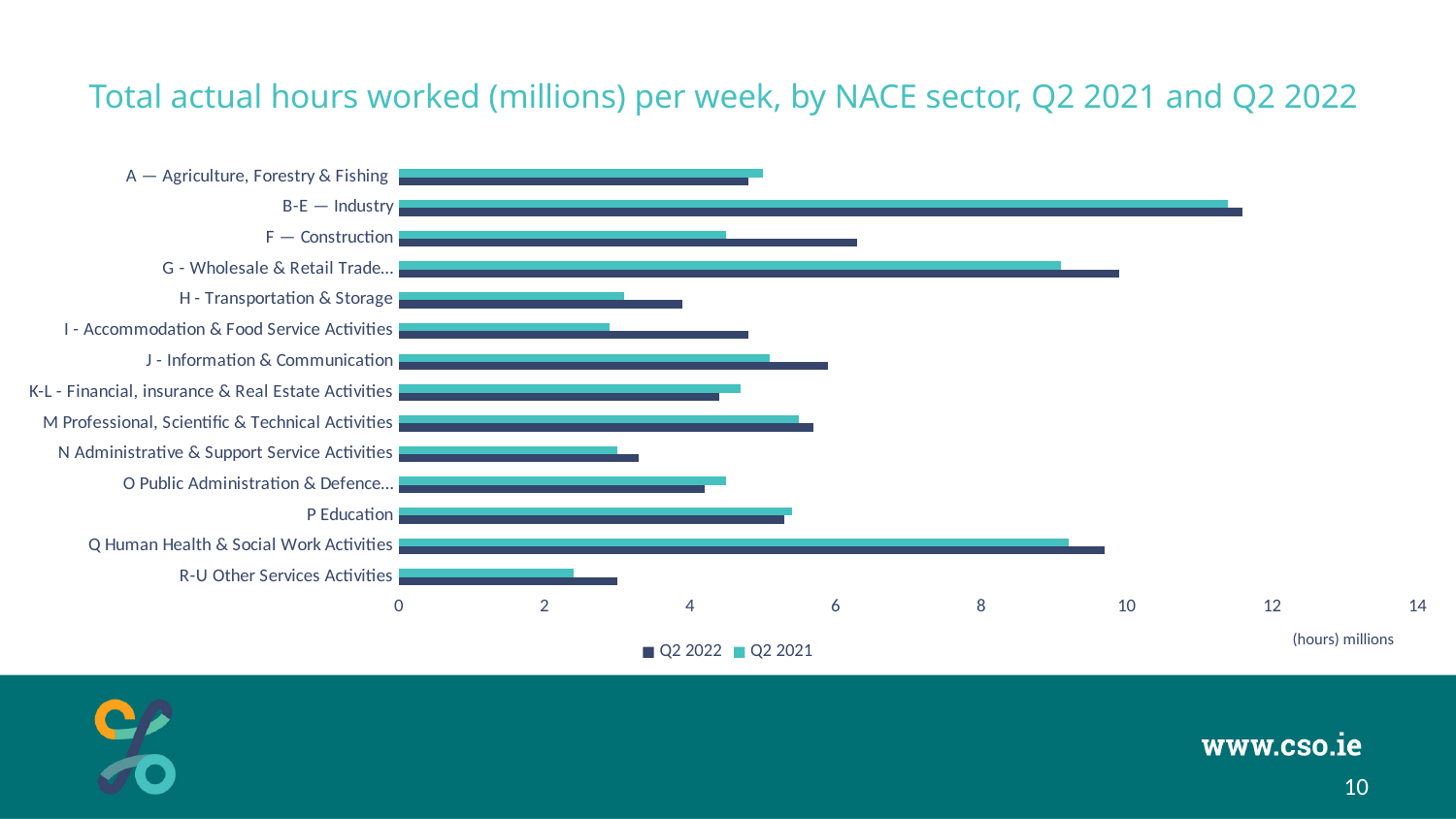
What kind of chart is shown on the slide? bar chart Is the Q2 2021 value for I - Accommodation & Food Service Activities greater or less than 4? less Which sector has the lowest Q2 2021 hours worked? R-U Other Services Activities Is the Q2 2022 value for B-E — Industry greater or less than 10? greater Which sector has the highest Q2 2022 hours worked? B-E — Industry How many NACE sectors are listed on the chart? 14 Is the Q2 2021 value for G - Wholesale & Retail Trade greater or less than 10? less For F — Construction, which is larger: Q2 2022 or Q2 2021? Q2 2022 For O Public Administration & Defence, which is larger: Q2 2022 or Q2 2021? Q2 2021 What are the two series named in the legend? Q2 2022 and Q2 2021 What unit label is shown under the horizontal axis? (hours) millions How many series does the legend list? 2